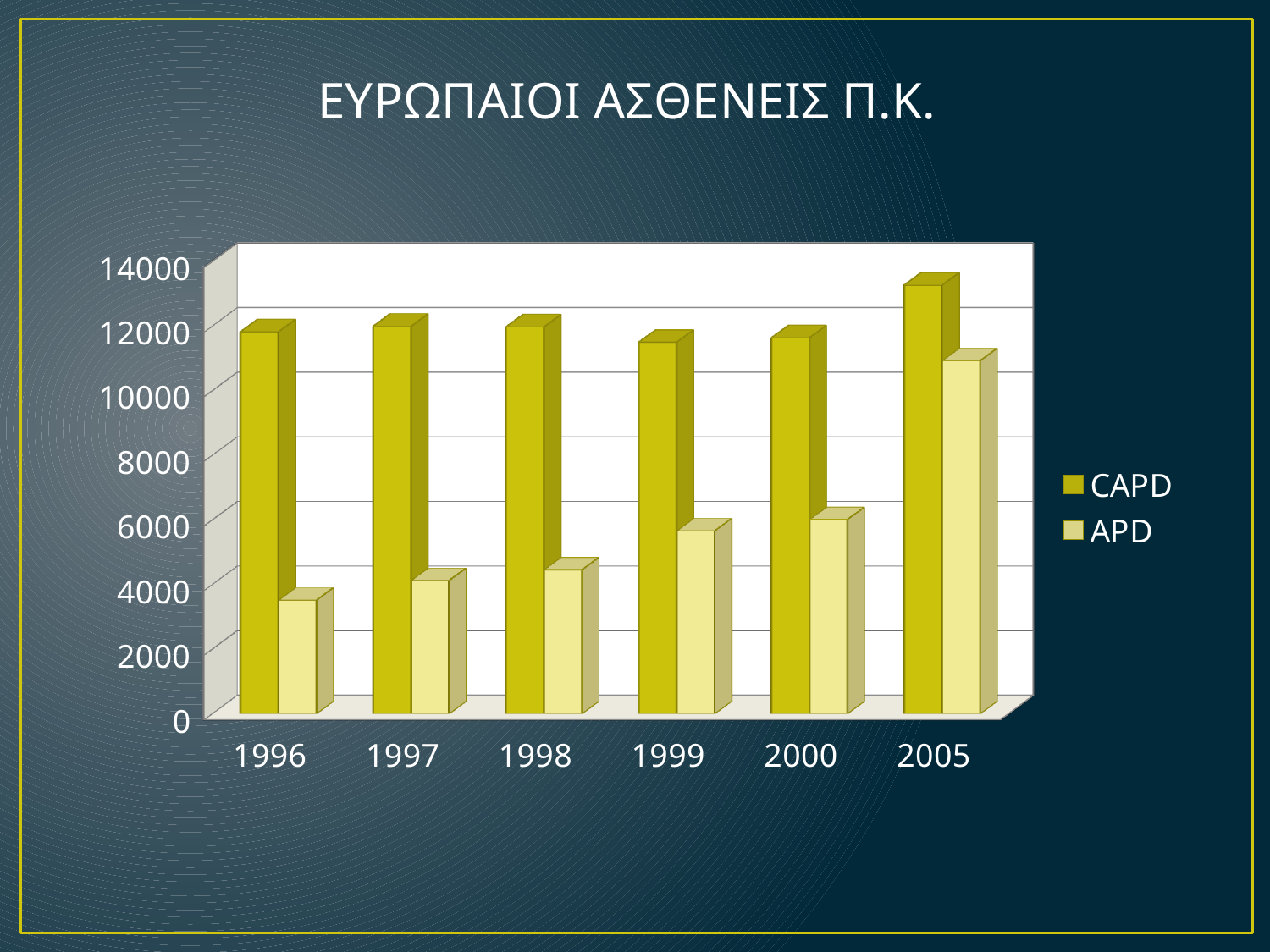
Do the APD values rise or fall from 1996 to 2005? rise How many series does the legend list? 2 Is the APD value for 1996 greater or less than 4000? less How many years are shown on the x axis? 6 What kind of chart is shown on the slide? bar chart What is the title of the chart? ΕΥΡΩΠΑΙΟΙ ΑΣΘΕΝΕΙΣ Π.Κ. Is the APD value for 2005 greater or less than 10000? greater Which year has the highest APD value? 2005 In 1996, which is larger, CAPD or APD? CAPD Which year has the lowest APD value? 1996 Is the CAPD value for 2005 greater or less than 12000? greater Which year has the highest CAPD value? 2005